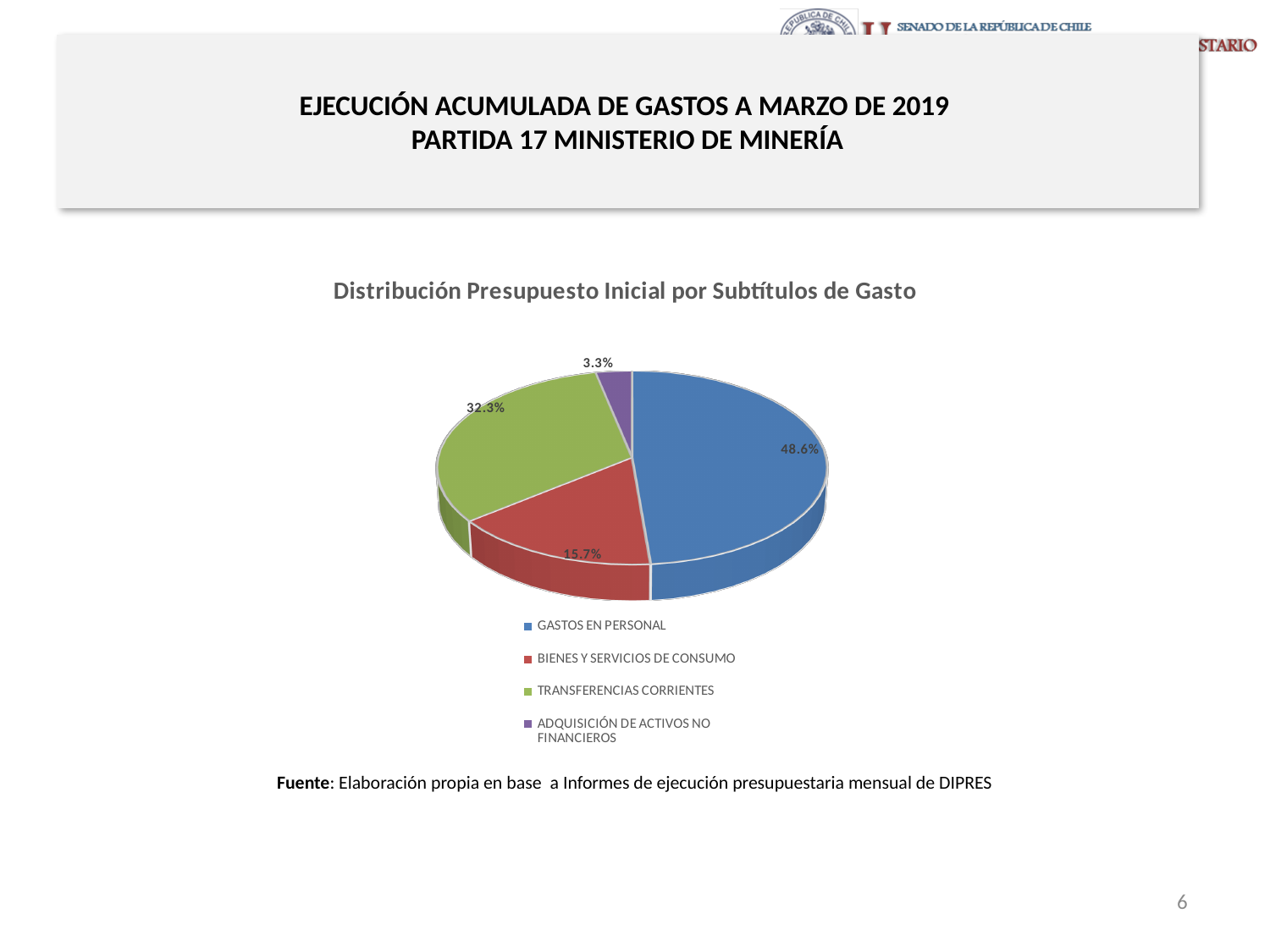
Which is larger, the share for BIENES Y SERVICIOS DE CONSUMO or the share for TRANSFERENCIAS CORRIENTES? TRANSFERENCIAS CORRIENTES What kind of chart is shown on the slide? Pie chart What colour is the slice for TRANSFERENCIAS CORRIENTES? Green What is the title of the chart? Distribución Presupuesto Inicial por Subtítulos de Gasto What is the difference in percentage points between GASTOS EN PERSONAL and TRANSFERENCIAS CORRIENTES? 16.3 What share of the pie does GASTOS EN PERSONAL represent? 48.6% What share of the pie does BIENES Y SERVICIOS DE CONSUMO represent? 15.7% Which category has the smallest share of the pie? ADQUISICIÓN DE ACTIVOS NO FINANCIEROS How many categories does the pie chart show? 4 What share of the pie does ADQUISICIÓN DE ACTIVOS NO FINANCIEROS represent? 3.3% Which category has the largest share of the pie? GASTOS EN PERSONAL